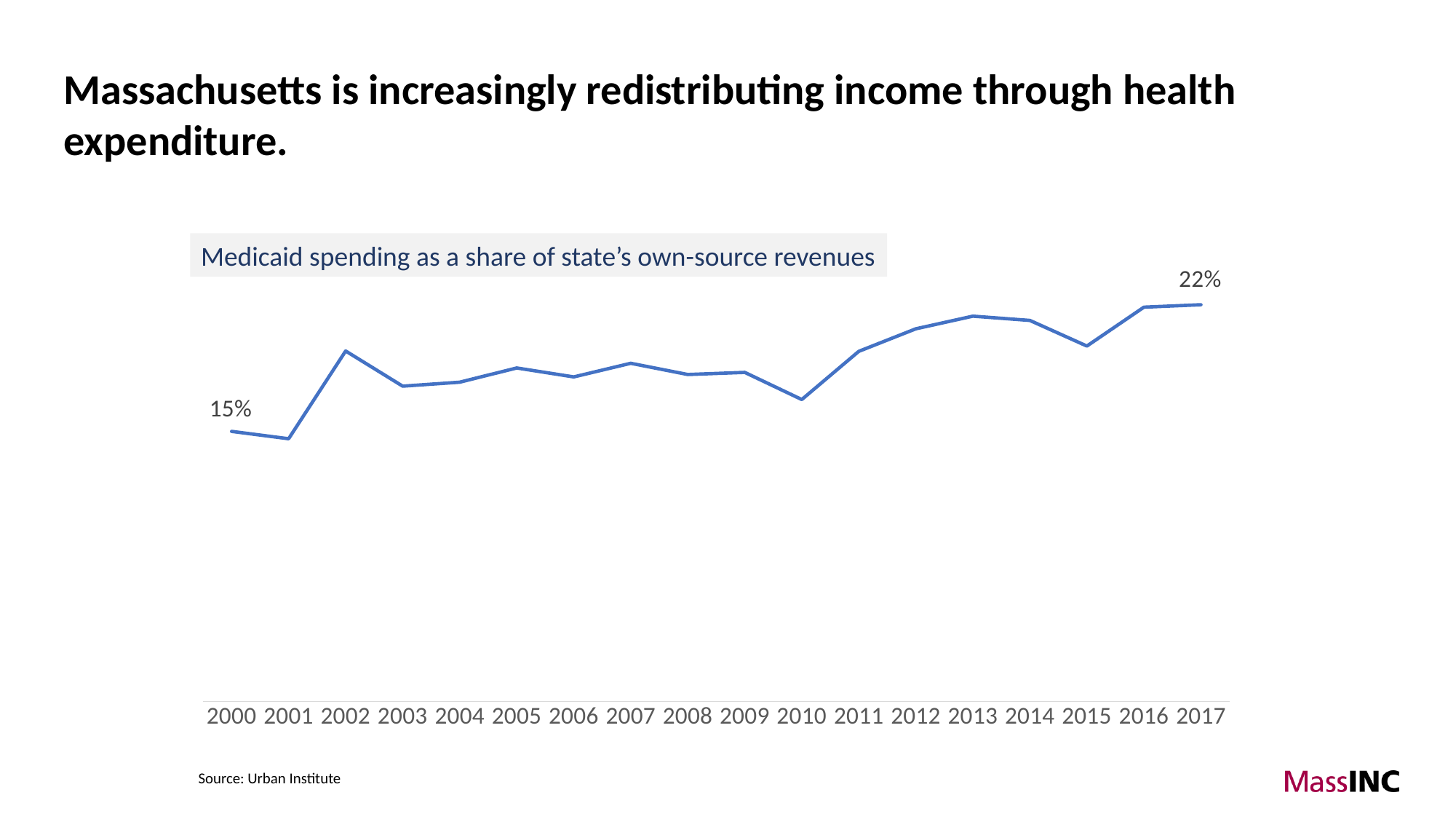
What is the difference between the value for 2017 and the value for 2000? 7 percentage points What kind of chart is shown on the slide? line chart What is the value for 2000? 15% Which is larger, the value for 2013 or the value for 2003? 2013 How many years are plotted on the x axis? 18 What is the value for 2017? 22% Which is larger, the value for 2000 or the value for 2017? 2017 What is the title of the chart? Medicaid spending as a share of state's own-source revenues What source is cited for the chart? Urban Institute Overall, do the values rise or fall from 2000 to 2017? rise Which is larger, the value for 2010 or the value for 2015? 2015